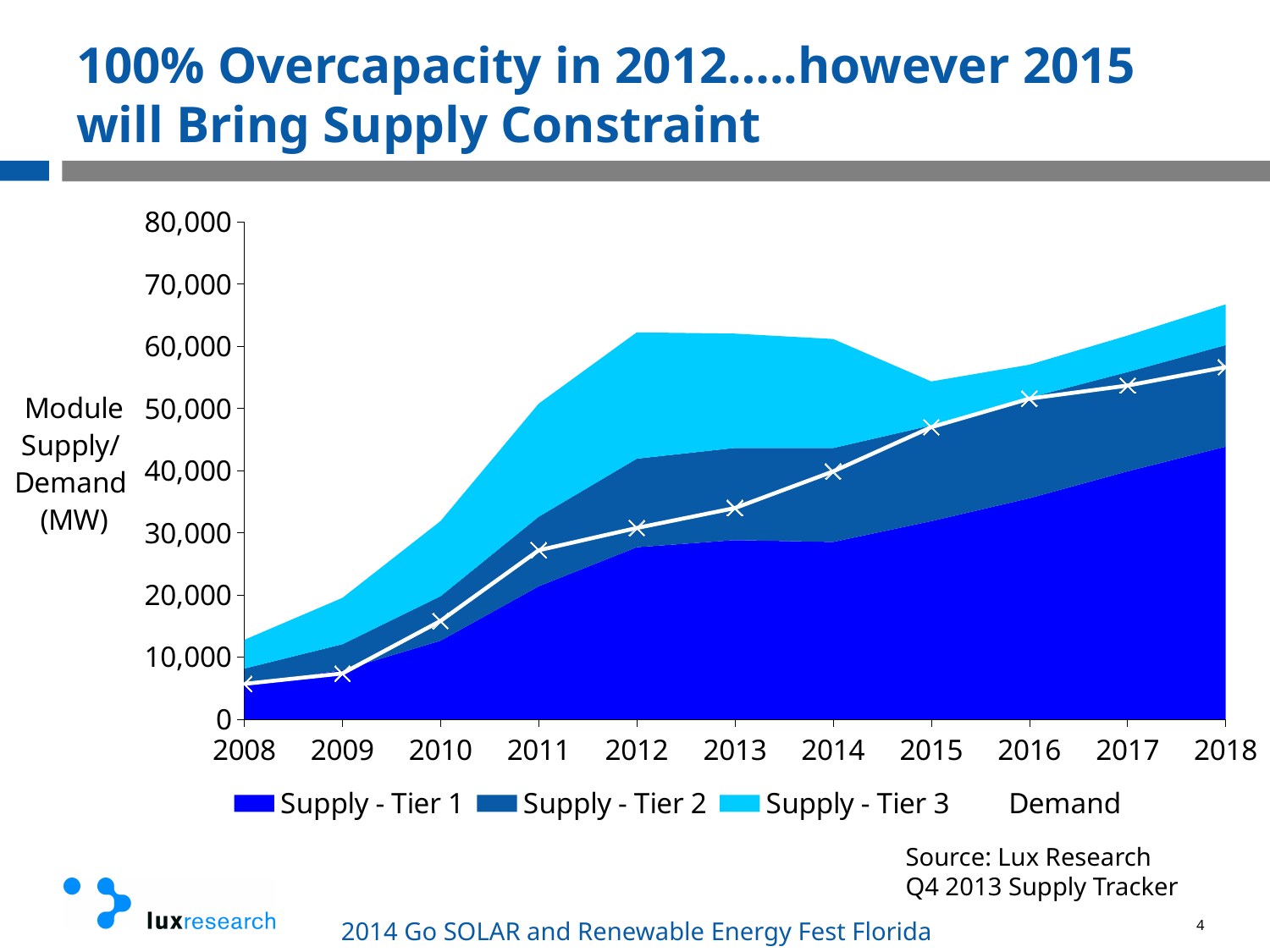
What kind of chart is shown on the slide? Stacked area chart with a line How many years are shown along the x axis? 11 How many series does the legend list? 4 Does the Demand line rise or fall from 2008 to 2018? rise Is the total supply (top of the stacked area) in 2015 greater or less than 60,000? less Is the Supply - Tier 1 value for 2018 greater or less than 40,000? greater What is the label on the y axis of the chart? Module Supply/Demand (MW) Is the Demand value for 2013 greater or less than 30,000? greater